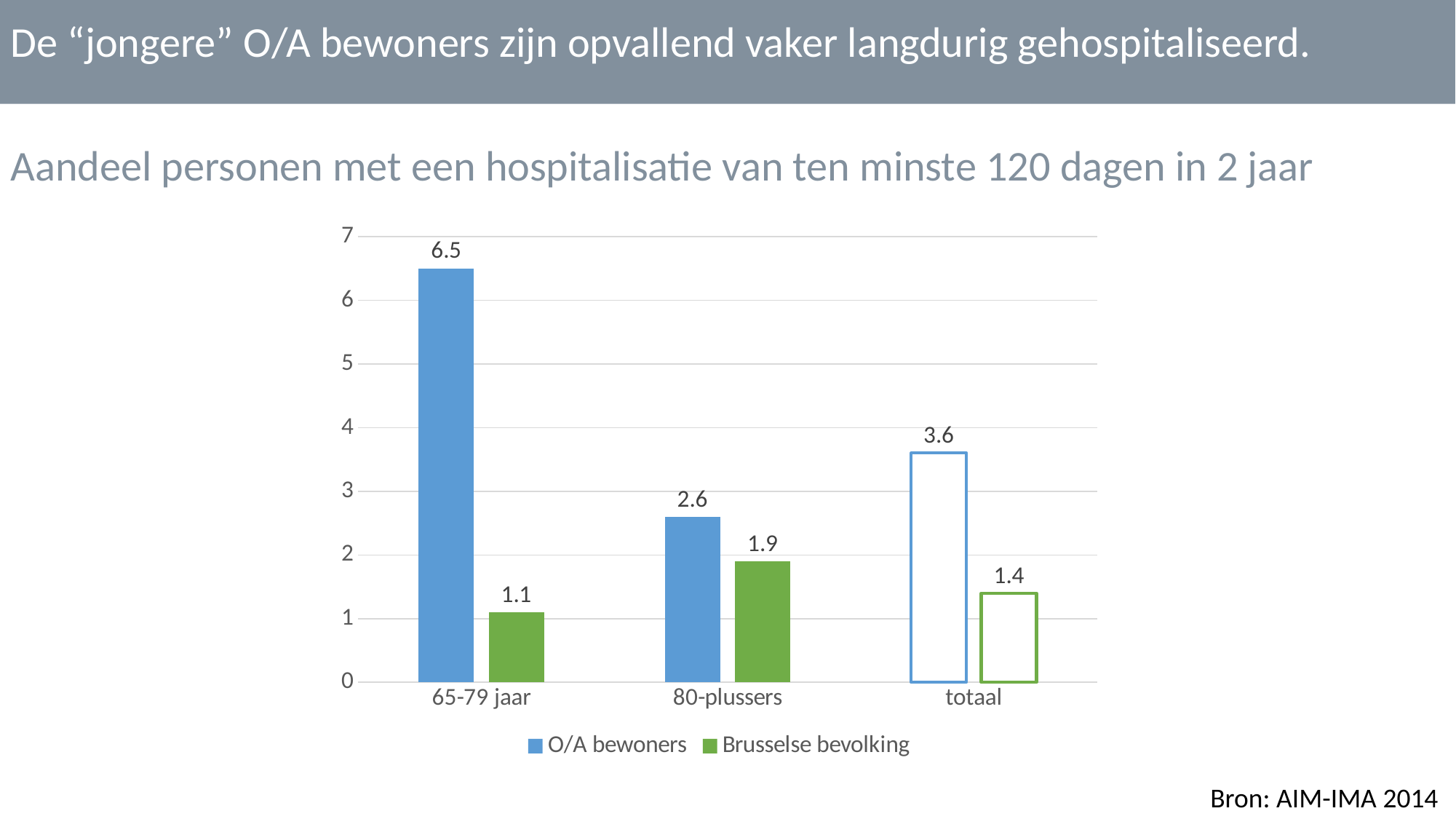
What is the value for Brusselse bevolking in the 65-79 jaar category? 1.1 What kind of chart is shown on the slide? bar chart Which category has the highest value for O/A bewoners? 65-79 jaar What is the value for Brusselse bevolking in the 80-plussers category? 1.9 Which is larger in the 80-plussers category: O/A bewoners or Brusselse bevolking? O/A bewoners What is the value for O/A bewoners in the 65-79 jaar category? 6.5 What is the value for O/A bewoners in the totaal category? 3.6 How many series does the legend list? 2 Which category has the lowest value for Brusselse bevolking? 65-79 jaar What is the difference between O/A bewoners and Brusselse bevolking in the 65-79 jaar category? 5.4 Is the value for O/A bewoners in the totaal category greater or less than 3? greater How many categories are shown on the x axis? 3